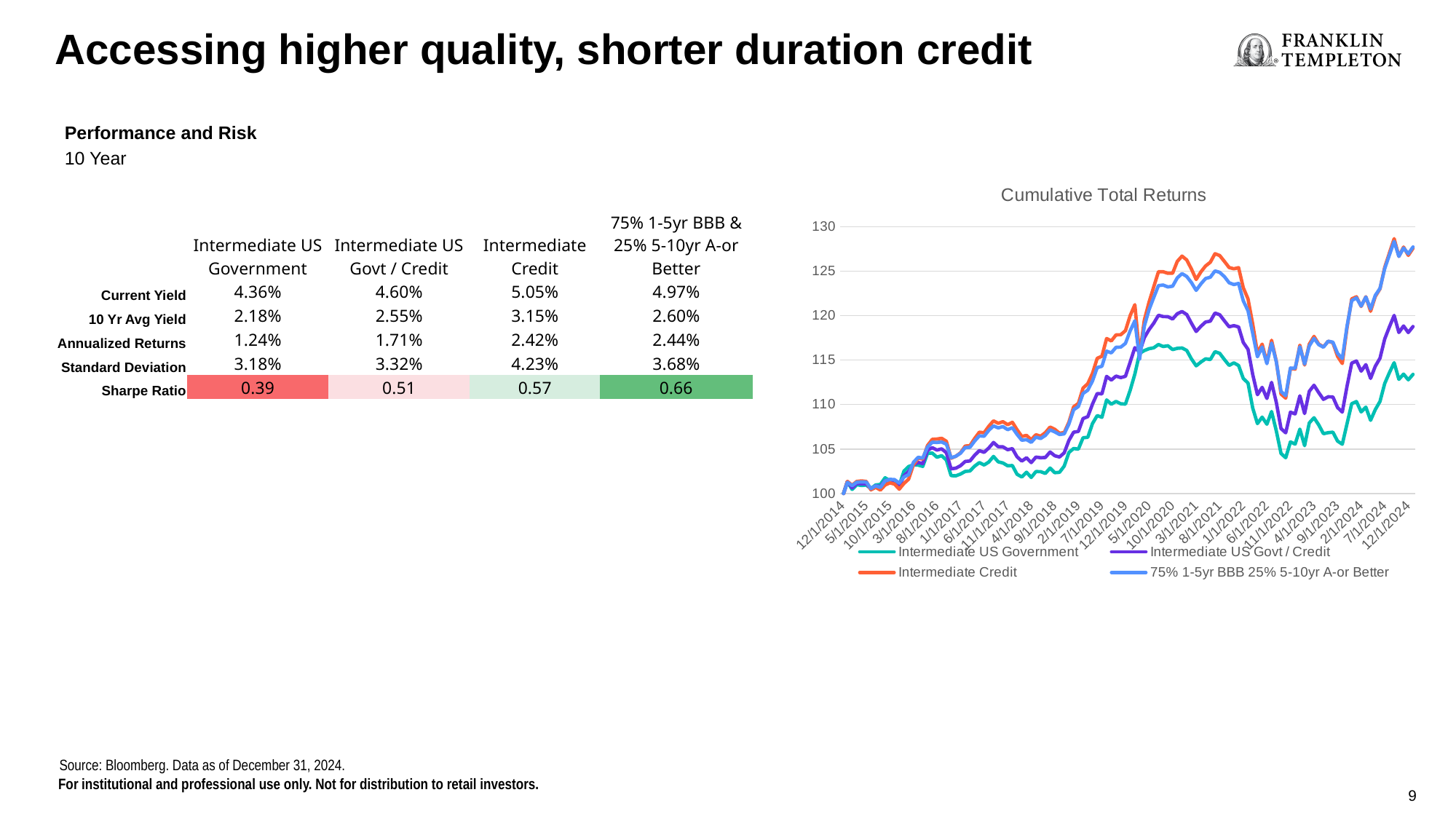
In the Cumulative Total Returns chart, is the value for Intermediate US Government at 12/1/2024 greater or less than 110? greater How many series does the legend of the Cumulative Total Returns chart list? 4 What type of chart is shown under the title "Cumulative Total Returns"? line chart In the Cumulative Total Returns chart, what value do all four series start at on 12/1/2014? 100 In the Cumulative Total Returns chart, is the value for Intermediate Credit at 12/1/2024 greater or less than 125? greater In the Cumulative Total Returns chart, what colour is the Intermediate Credit line? orange In the Cumulative Total Returns chart, do the series generally rise or fall from 12/1/2014 to 12/1/2024? rise In the Cumulative Total Returns chart, is the value for Intermediate US Government at 12/1/2024 greater or less than 115? less In the Cumulative Total Returns chart, which is higher at 12/1/2024: Intermediate Credit or Intermediate US Government? Intermediate Credit What is the title of the chart on the right side of the slide? Cumulative Total Returns In the Cumulative Total Returns chart, which series has the lowest value at 12/1/2024? Intermediate US Government